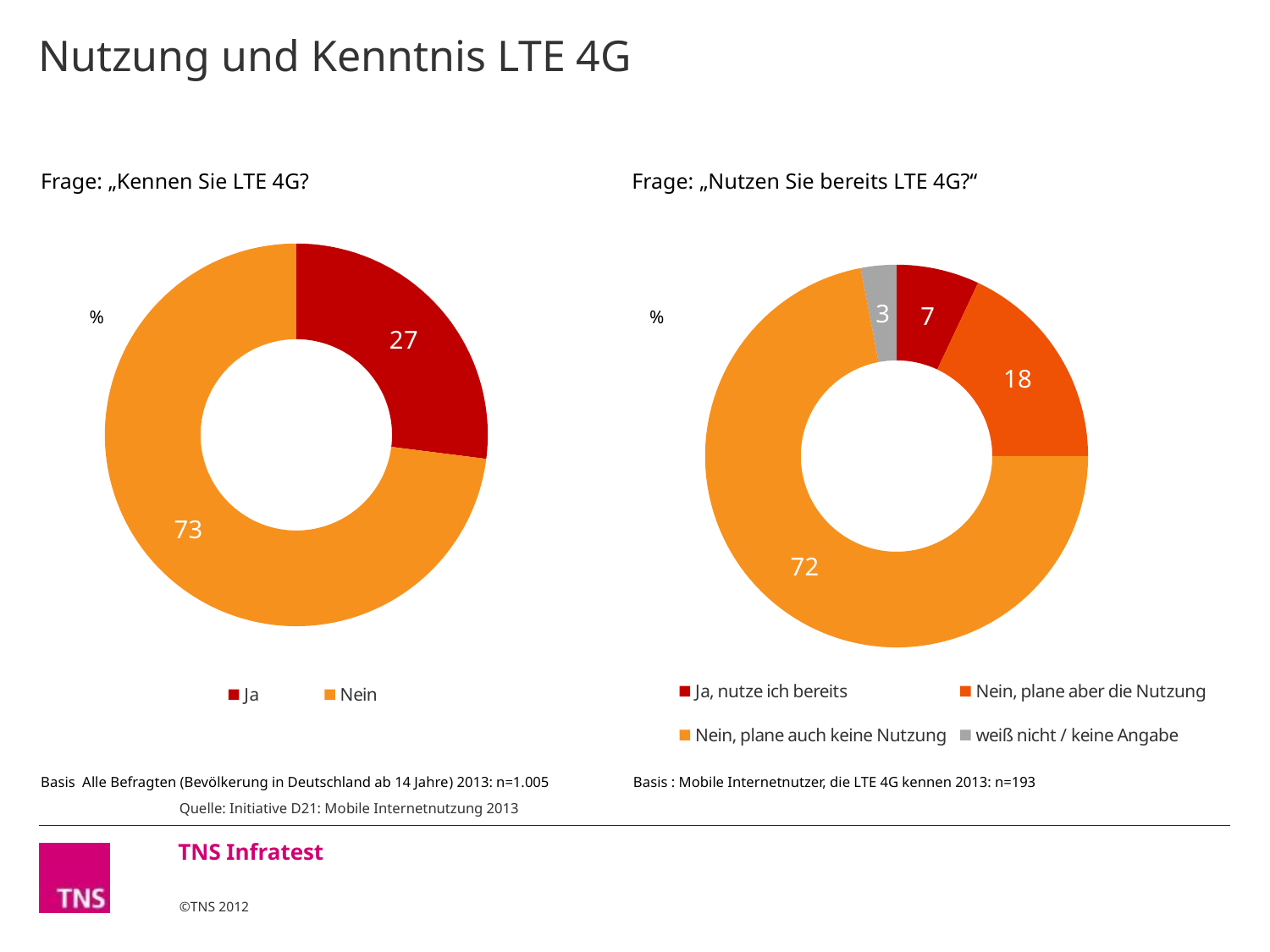
In the right chart ("Nutzen Sie bereits LTE 4G?"), what is the difference between "Nein, plane auch keine Nutzung" and "Nein, plane aber die Nutzung"? 54 In the left chart ("Kennen Sie LTE 4G?"), what is the difference between the "Nein" and "Ja" shares? 46 In the right chart ("Nutzen Sie bereits LTE 4G?"), how many categories does the legend list? 4 What kind of chart is used on the left for "Kennen Sie LTE 4G?"? Doughnut (pie) chart In the right chart ("Nutzen Sie bereits LTE 4G?"), which is larger: "Ja, nutze ich bereits" or "Nein, plane aber die Nutzung"? Nein, plane aber die Nutzung In the right chart ("Nutzen Sie bereits LTE 4G?"), what percentage answered "Ja, nutze ich bereits"? 7 In the right chart ("Nutzen Sie bereits LTE 4G?"), what percentage answered "Nein, plane auch keine Nutzung"? 72 In the left chart ("Kennen Sie LTE 4G?"), which answer has the larger share? Nein In the right chart ("Nutzen Sie bereits LTE 4G?"), what percentage answered "Nein, plane aber die Nutzung"? 18 In the left chart ("Kennen Sie LTE 4G?"), what percentage answered "Ja"? 27 In the left chart ("Kennen Sie LTE 4G?"), what percentage answered "Nein"? 73 In the right chart ("Nutzen Sie bereits LTE 4G?"), which answer has the smallest share? weiß nicht / keine Angabe